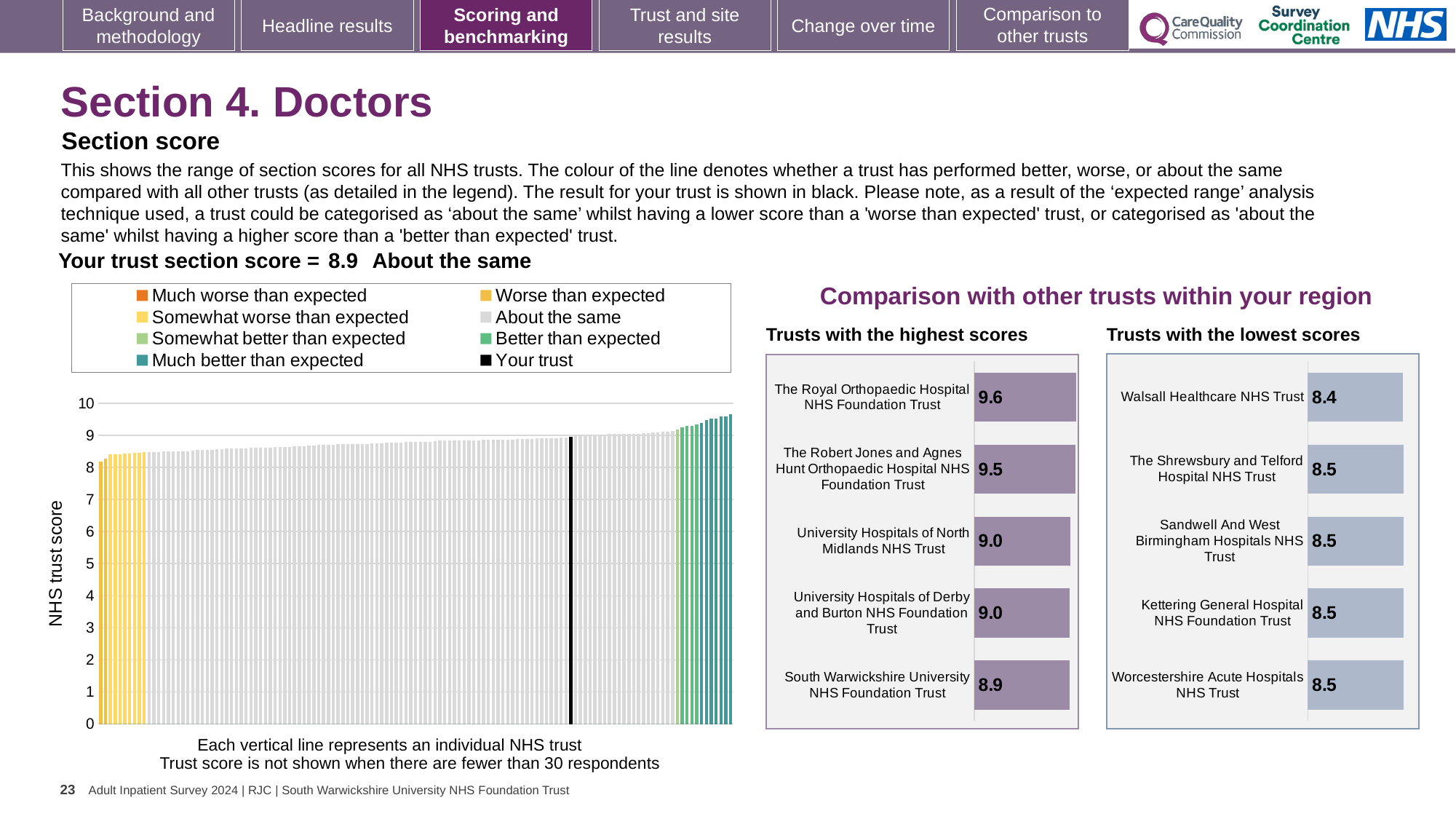
In the 'Trusts with the lowest scores' chart, what is the score for Kettering General Hospital NHS Foundation Trust? 8.5 In the 'Trusts with the highest scores' chart, what is the difference between the scores of The Royal Orthopaedic Hospital NHS Foundation Trust and South Warwickshire University NHS Foundation Trust? 0.7 In the large chart on the left, what is the section score for your trust (the black bar)? 8.9 In the 'Trusts with the lowest scores' chart, what is the score for Walsall Healthcare NHS Trust? 8.4 In the 'Trusts with the lowest scores' chart, which trust has the lowest score? Walsall Healthcare NHS Trust In the 'Trusts with the highest scores' chart, which trust has the highest score? The Royal Orthopaedic Hospital NHS Foundation Trust In the 'Trusts with the lowest scores' chart, what is the difference between the scores of The Shrewsbury and Telford Hospital NHS Trust and Walsall Healthcare NHS Trust? 0.1 In the 'Trusts with the highest scores' chart, how many trusts are shown? 5 In the large chart on the left, is the value of the tallest bar greater or less than 10? less In the 'Trusts with the highest scores' chart, what is the score for South Warwickshire University NHS Foundation Trust? 8.9 In the large chart on the left, how many entries does the legend list? 8 In the 'Trusts with the highest scores' chart, what is the score for The Royal Orthopaedic Hospital NHS Foundation Trust? 9.6